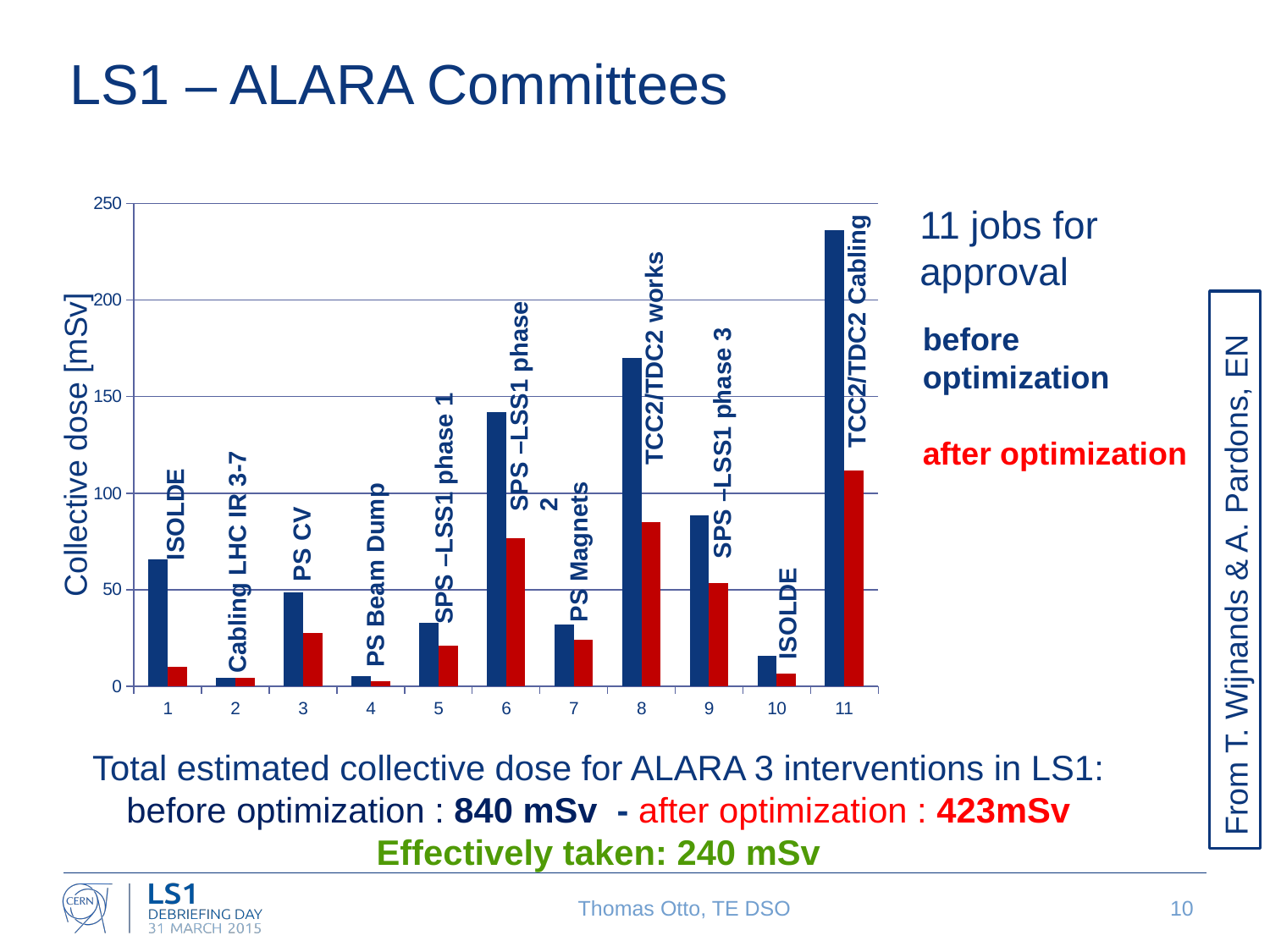
How many jobs (categories) are plotted along the x axis? 11 Is the before-optimization value for TCC2/TDC2 Cabling (job 11) greater or less than 200 mSv? greater Which job has the highest collective dose before optimization? TCC2/TDC2 Cabling (job 11) What is the label of the y axis? Collective dose [mSv] Which has the larger before-optimization dose: TCC2/TDC2 works (job 8) or SPS-LSS1 phase 2 (job 6)? TCC2/TDC2 works (job 8) Which has the larger after-optimization dose: SPS-LSS1 phase 3 (job 9) or PS Magnets (job 7)? SPS-LSS1 phase 3 (job 9) What kind of chart is shown on the slide? bar chart Is the after-optimization value for TCC2/TDC2 Cabling (job 11) greater or less than 100 mSv? greater Is the before-optimization value for TCC2/TDC2 works (job 8) greater or less than 150 mSv? greater How many series does the chart show? 2 Which job has the highest collective dose after optimization? TCC2/TDC2 Cabling (job 11)